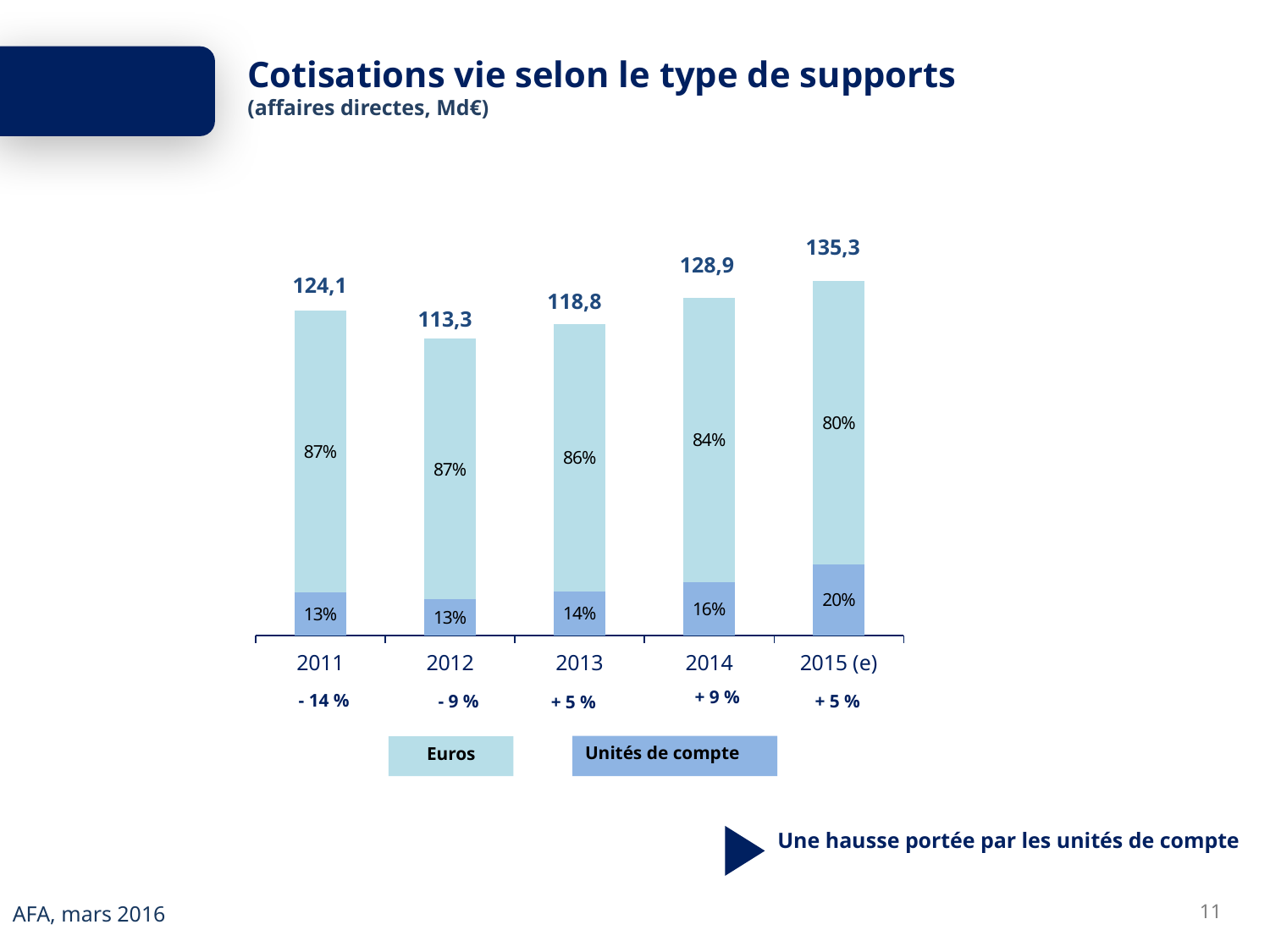
How many years are shown on the x axis? 5 Which year has the lowest total value? 2012 What percentage of the 2011 bar is labelled for Euros? 87% What growth rate is printed below the 2011 bar? - 14 % Which is larger, the total for 2011 or the total for 2013? 2011 What is the difference between the total for 2015 (e) and the total for 2014? 6,4 Which year has the highest total value? 2015 (e) How many series does the legend list? 2 Does the Unités de compte share rise or fall from 2011 to 2015 (e)? Rise What is the total value shown above the bar for 2015 (e)? 135,3 What kind of chart is shown on the slide? Stacked bar chart What percentage of the 2014 bar is labelled for Unités de compte? 16%